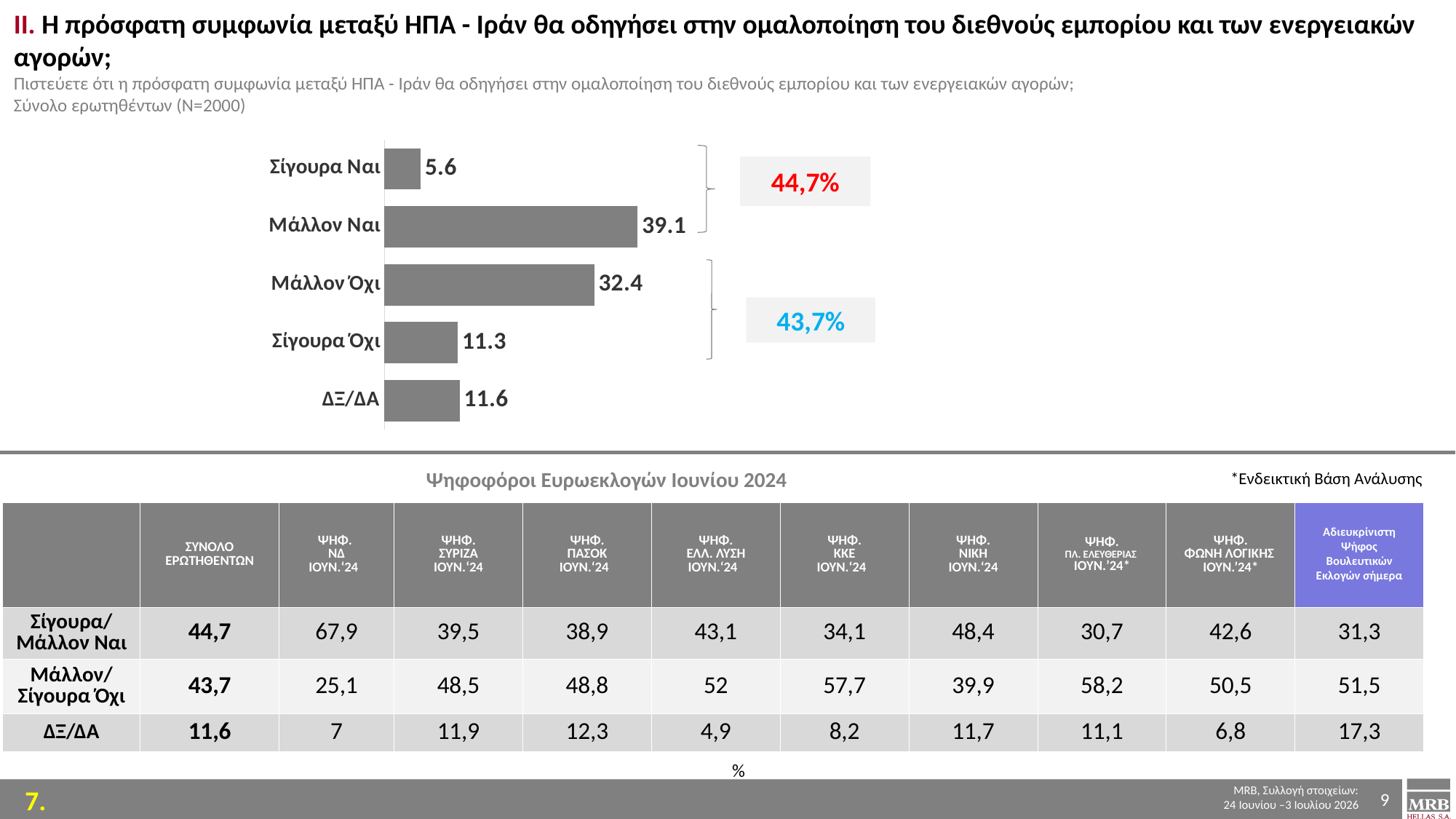
How many categories are shown in the bar chart? 5 What is the sum of the values for "Σίγουρα Ναι" and "Μάλλον Ναι" in the bar chart? 44.7 What value is shown for "ΔΞ/ΔΑ" in the bar chart? 11.6 What value is shown for "Σίγουρα Όχι" in the bar chart? 11.3 Which is larger in the bar chart: the value for "Σίγουρα Όχι" or the value for "Σίγουρα Ναι"? Σίγουρα Όχι What combined percentage is shown in blue next to the bracket grouping "Μάλλον Όχι" and "Σίγουρα Όχι"? 43,7% What combined percentage is shown in red next to the bracket grouping "Σίγουρα Ναι" and "Μάλλον Ναι"? 44,7% Which category has the highest value in the bar chart? Μάλλον Ναι What value is shown for "Μάλλον Ναι" in the bar chart? 39.1 What type of chart is shown on the slide? bar chart What is the difference between the values for "Μάλλον Ναι" and "Μάλλον Όχι" in the bar chart? 6.7 Which category has the lowest value in the bar chart? Σίγουρα Ναι